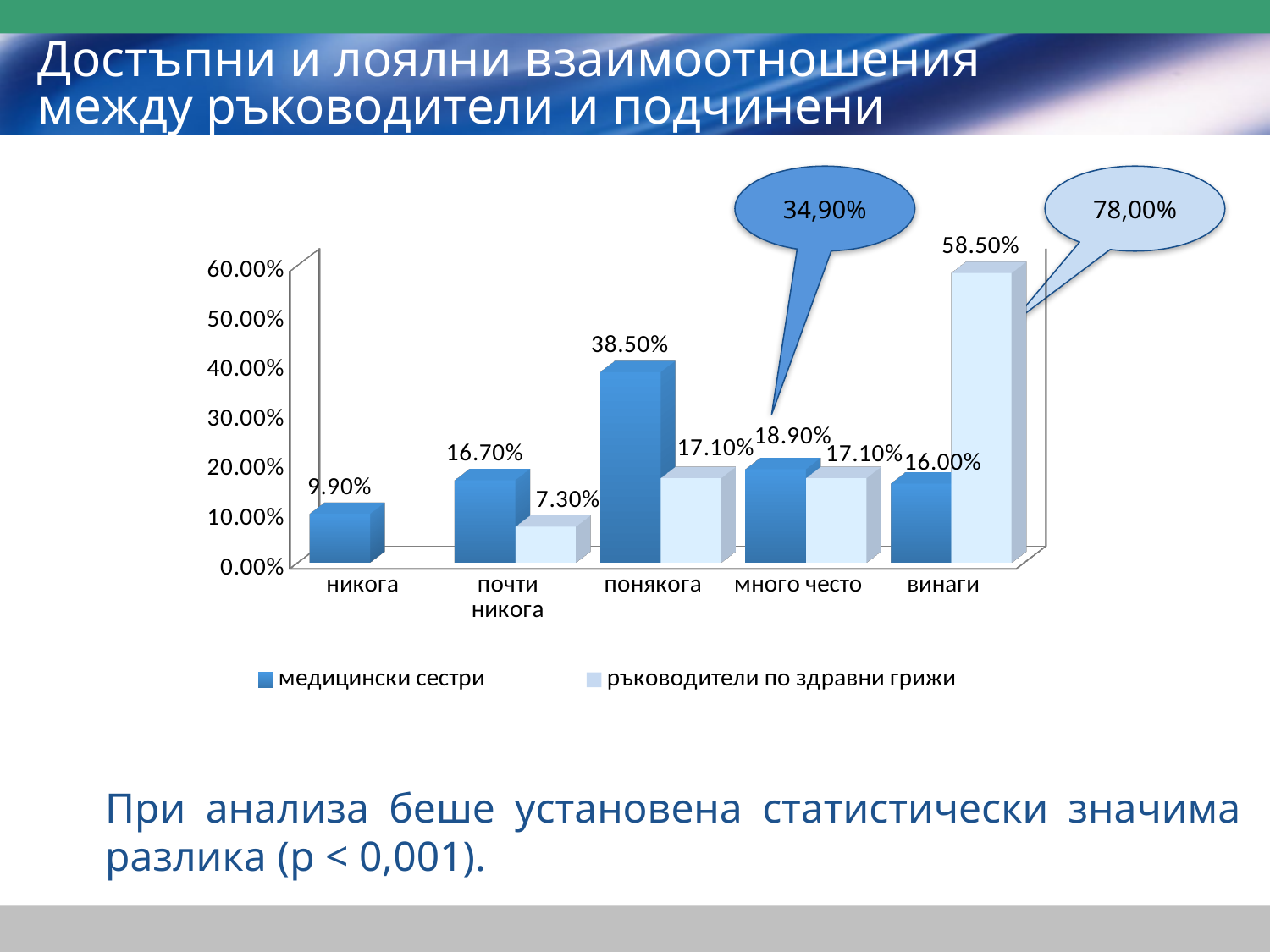
What value is shown in the callout pointing to the винаги bars? 78,00% Which category has the highest value for медицински сестри? понякога What is the value for медицински сестри in the понякога category? 38.50% In the почти никога category, which series has the larger value: медицински сестри or ръководители по здравни грижи? медицински сестри What is the value for медицински сестри in the никога category? 9.90% What is the value for ръководители по здравни грижи in the винаги category? 58.50% How many series does the legend list? 2 What is the value for ръководители по здравни грижи in the почти никога category? 7.30% How many categories are shown on the x axis? 5 Which category has the lowest value for медицински сестри? никога What kind of chart is shown on the slide? bar chart What is the difference between the медицински сестри and ръководители по здравни грижи values in the винаги category? 42.50%